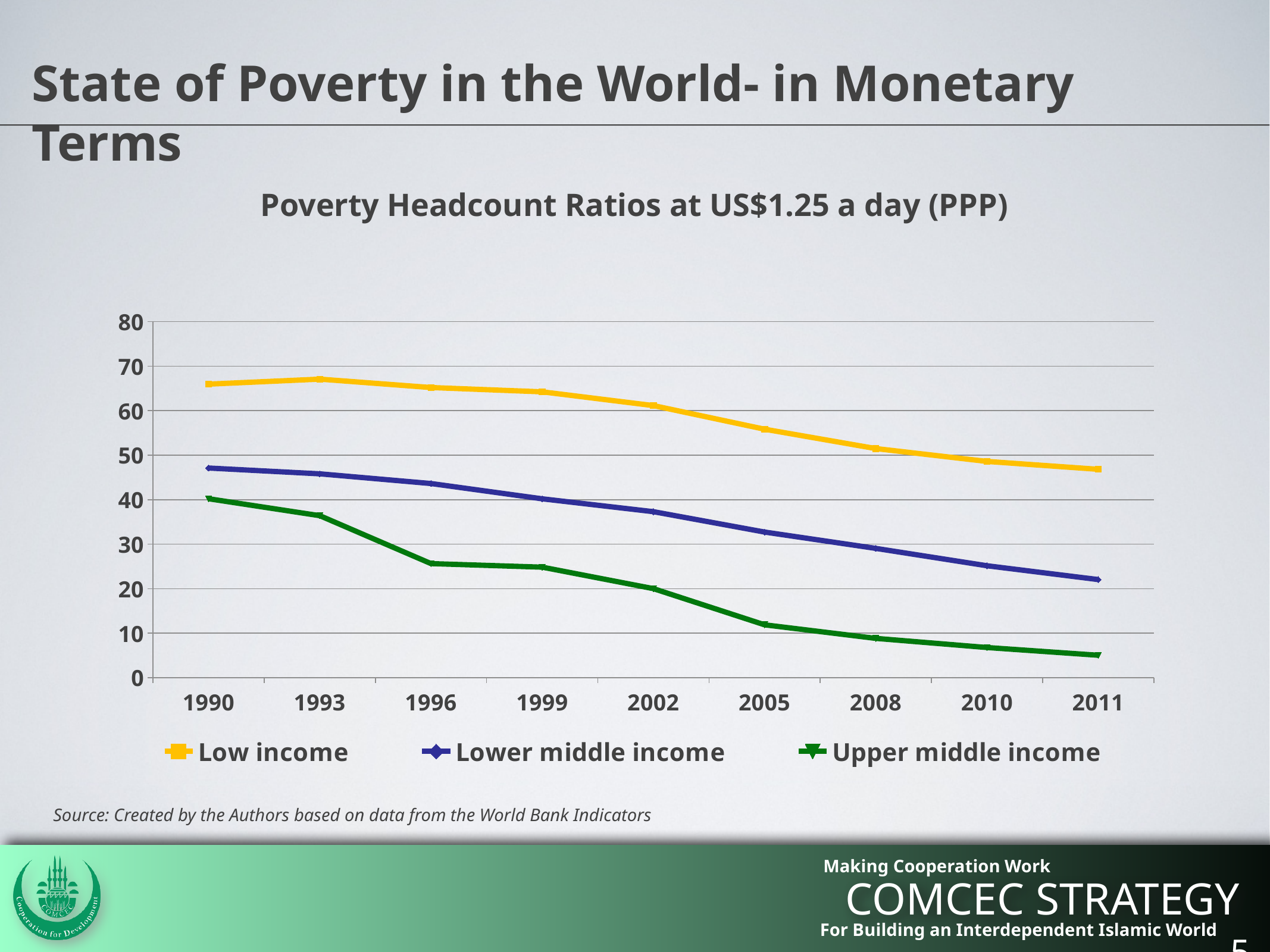
Which series has the lowest value in 1990? Upper middle income Is the value for Upper middle income in 2011 greater or less than 10? less Is the value for Low income in 1990 greater or less than 60? greater Which is larger in 2002, the value for Lower middle income or the value for Upper middle income? Lower middle income What kind of chart is shown on the slide? line chart Is the value for Upper middle income in 1996 greater or less than 30? less How many series does the legend list? 3 How many years are shown along the x axis? 9 Do the values for Upper middle income rise or fall from 1990 to 2011? fall What is the title of the chart? Poverty Headcount Ratios at US$1.25 a day (PPP) Which series has the highest value in 2011? Low income